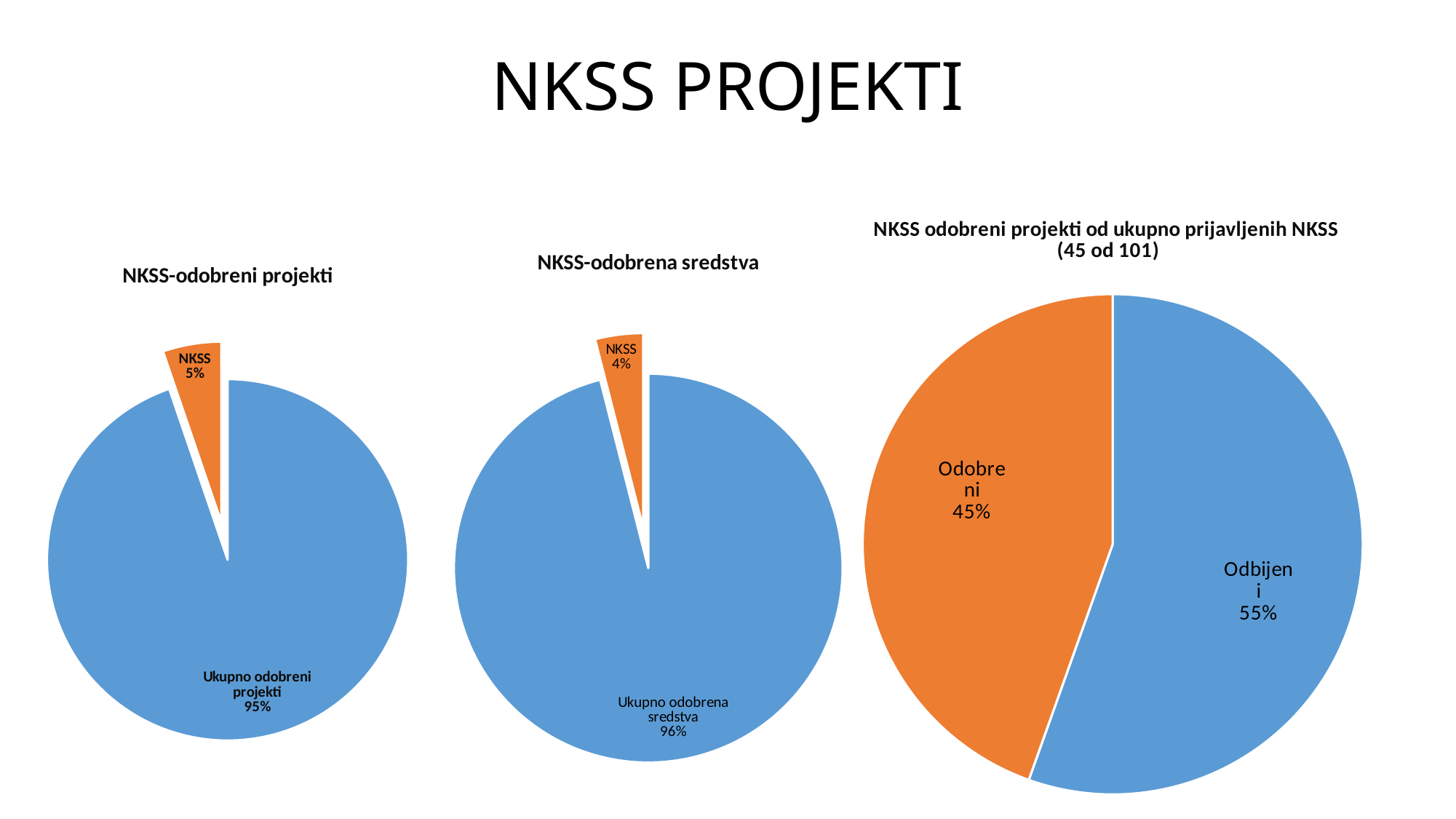
In the rightmost chart, what is the difference in percentage points between the 'Odbijeni' and 'Odobreni' slices? 10 percentage points In the 'NKSS-odobreni projekti' chart, which slice is the smallest? NKSS What kind of chart is 'NKSS-odobreni projekti'? Pie chart How many slices does the rightmost chart, 'NKSS odobreni projekti od ukupno prijavljenih NKSS', have? 2 In the rightmost chart, which slice is larger, 'Odobreni' or 'Odbijeni'? Odbijeni In the rightmost chart, 'NKSS odobreni projekti od ukupno prijavljenih NKSS', what share is labelled 'Odobreni'? 45% In the 'NKSS-odobrena sredstva' chart, what share does the NKSS slice have? 4% In the rightmost chart, 'NKSS odobreni projekti od ukupno prijavljenih NKSS', what share is labelled 'Odbijeni'? 55% In the 'NKSS-odobrena sredstva' chart, which slice is the largest? Ukupno odobrena sredstva